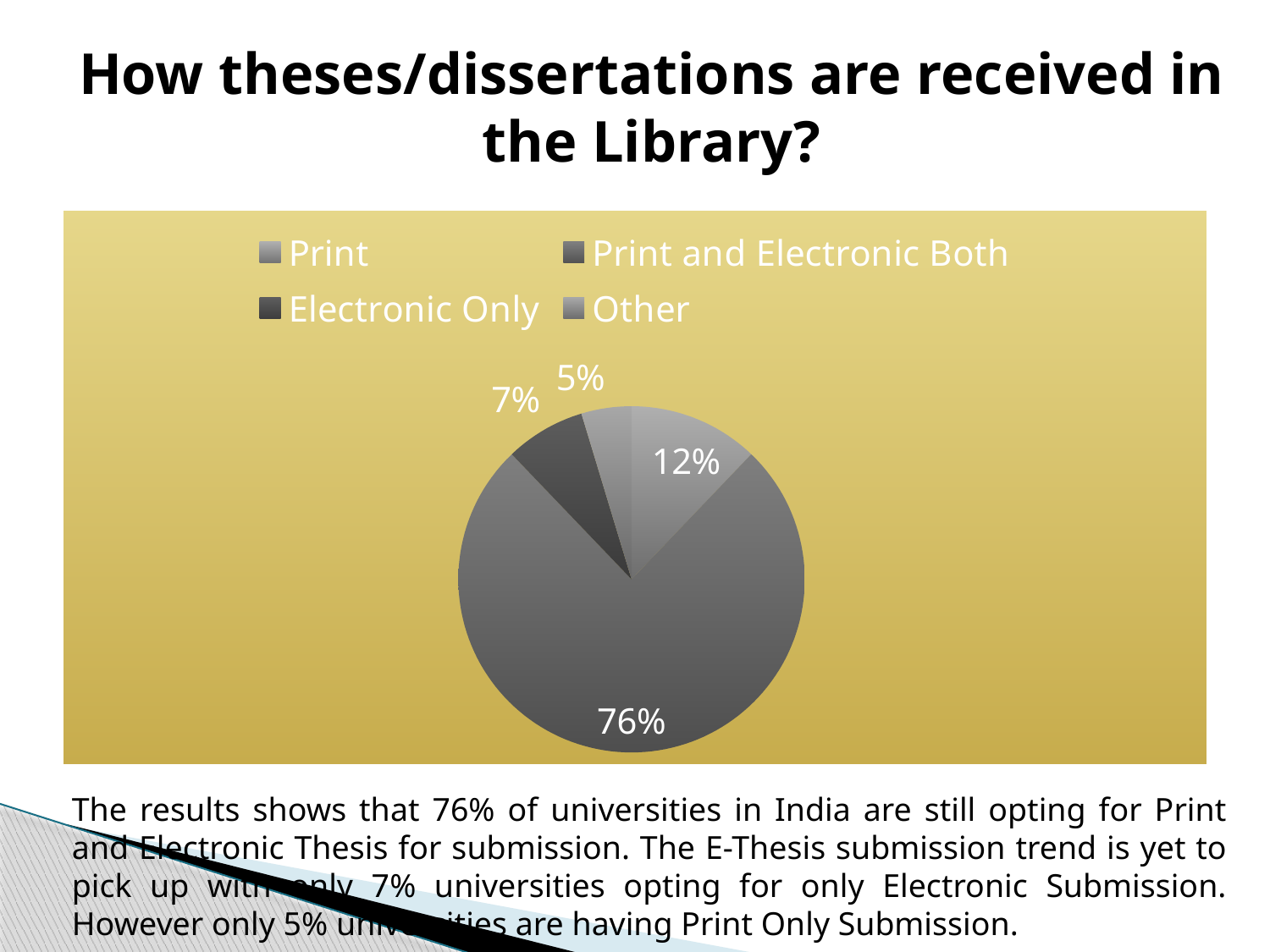
Which category has the largest slice of the pie? Print and Electronic Both What percentage of the pie is labelled for Other? 5% What percentage of the pie is labelled for Print and Electronic Both? 76% What type of chart is shown on the slide? pie chart What percentage of the pie is labelled for Electronic Only? 7% What is the difference in percentage points between Print and Electronic Both and Other? 71 What is the title of the slide containing the pie chart? How theses/dissertations are received in the Library? Which category has the smallest slice of the pie? Other What percentage of the pie is labelled for Print? 12% How many categories does the legend list? 4 Which is larger, the slice for Electronic Only or the slice for Other? Electronic Only What is the combined share of Print and Electronic Only? 19%